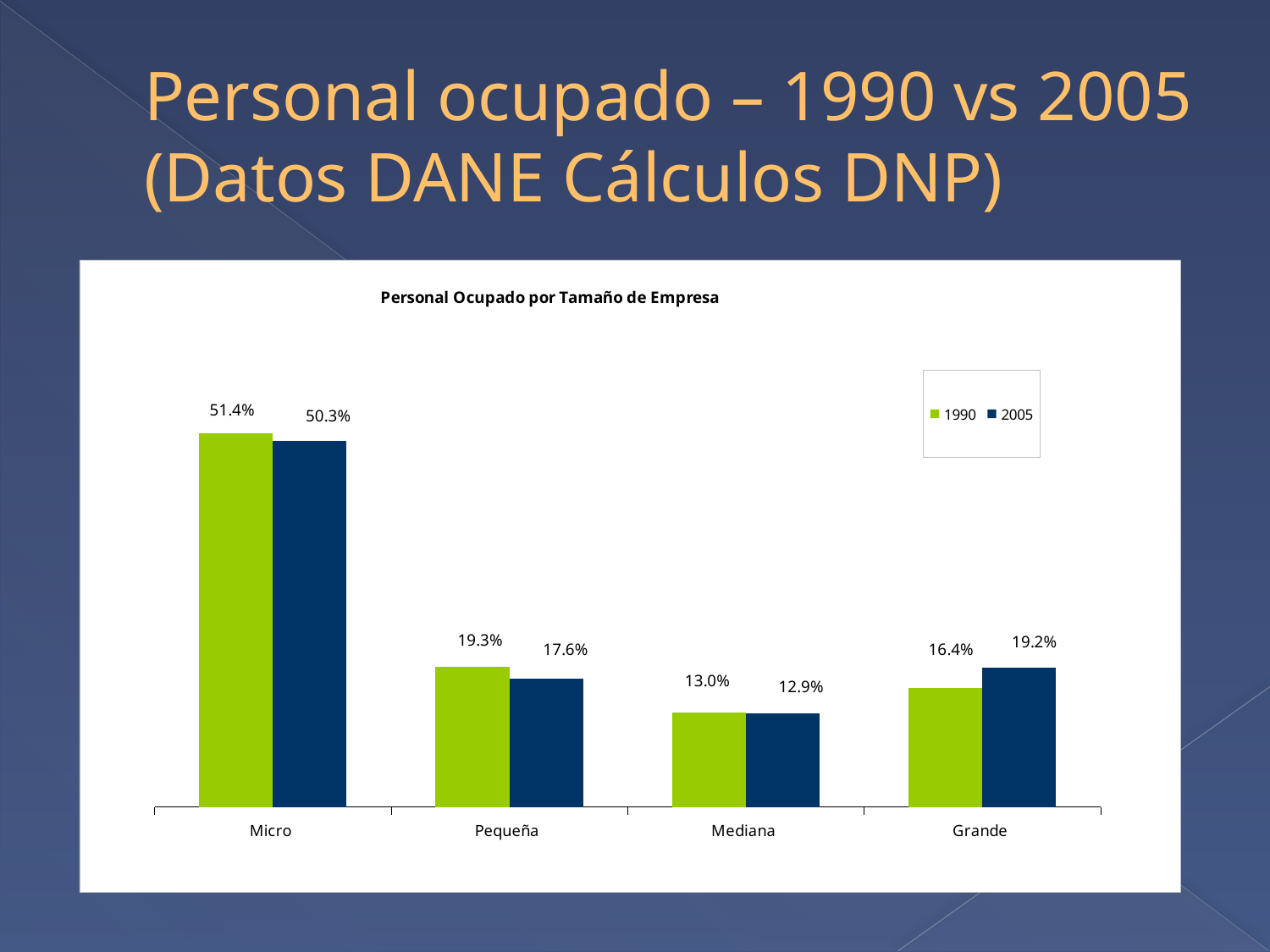
Which category has the highest value in the 1990 series? Micro What is the value for Mediana in the 2005 series? 12.9% What is the value for Micro in the 1990 series? 51.4% For Grande, which series has the larger value, 1990 or 2005? 2005 How many categories are shown on the x axis? 4 What is the value for Grande in the 2005 series? 19.2% What is the title of the chart? Personal Ocupado por Tamaño de Empresa What kind of chart is shown on the slide? Bar chart What is the difference between the 2005 values for Micro and Grande? 31.1% How many series does the legend list? 2 Which category has the lowest value in the 2005 series? Mediana What is the difference between the 1990 and 2005 values for Pequeña? 1.7%